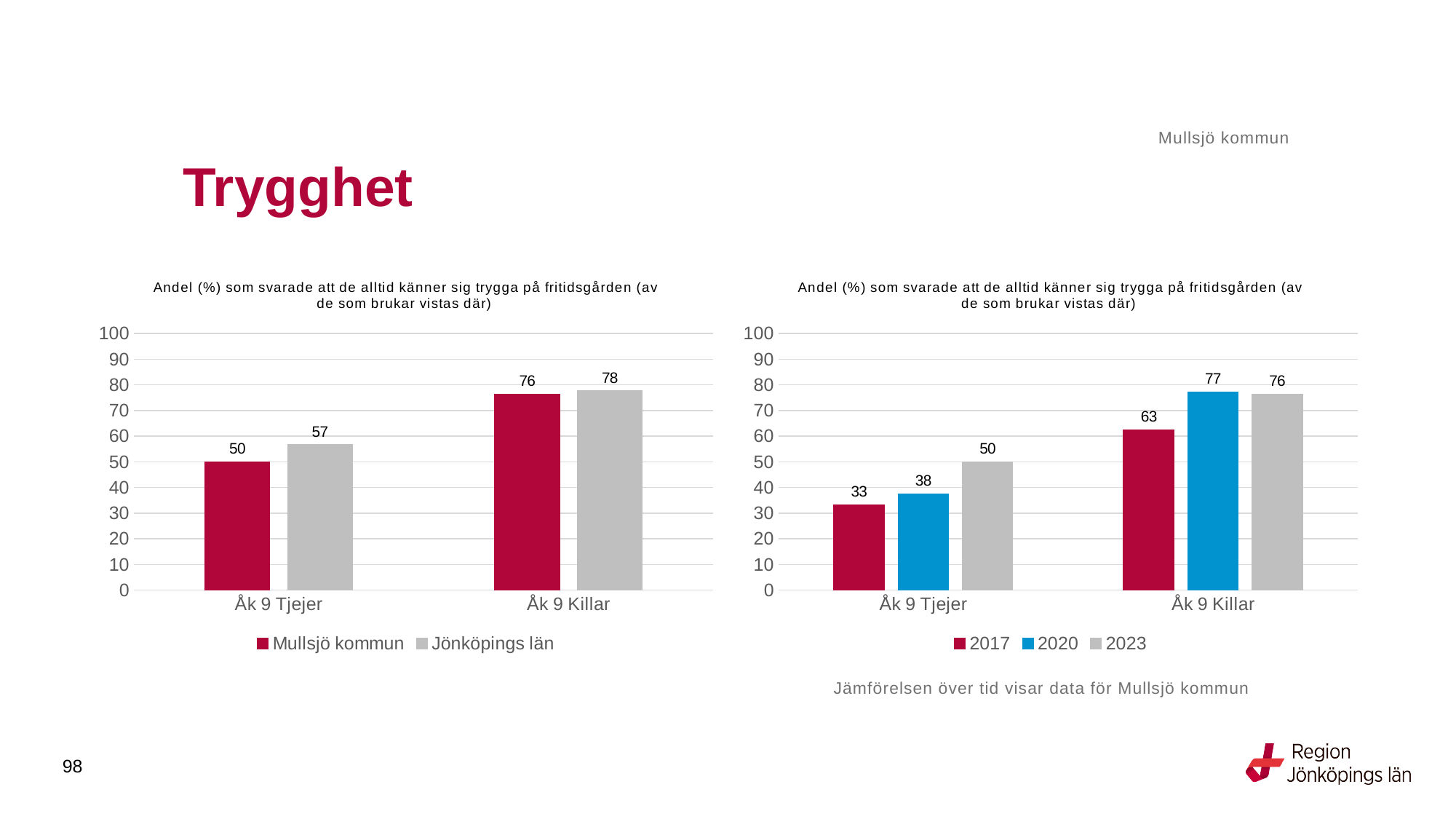
In the left chart, how many series does the legend list? 2 What kind of chart is the left chart? bar chart In the right chart, which year has the highest value for Åk 9 Tjejer? 2023 In the right chart, is the 2017 value for Åk 9 Killar greater or less than 60? greater In the left chart, what is the difference between Jönköpings län and Mullsjö kommun for Åk 9 Tjejer? 7 In the right chart, what is the value for 2020 for Åk 9 Killar? 77 In the right chart, which year has the lowest value for Åk 9 Killar? 2017 In the left chart, what is the value for Mullsjö kommun for Åk 9 Tjejer? 50 In the right chart, what is the difference between the 2023 and 2017 values for Åk 9 Tjejer? 17 In the right chart, do the values for Åk 9 Tjejer rise or fall from 2017 to 2023? rise In the left chart, what is the value for Jönköpings län for Åk 9 Killar? 78 In the right chart, what is the value for 2017 for Åk 9 Tjejer? 33